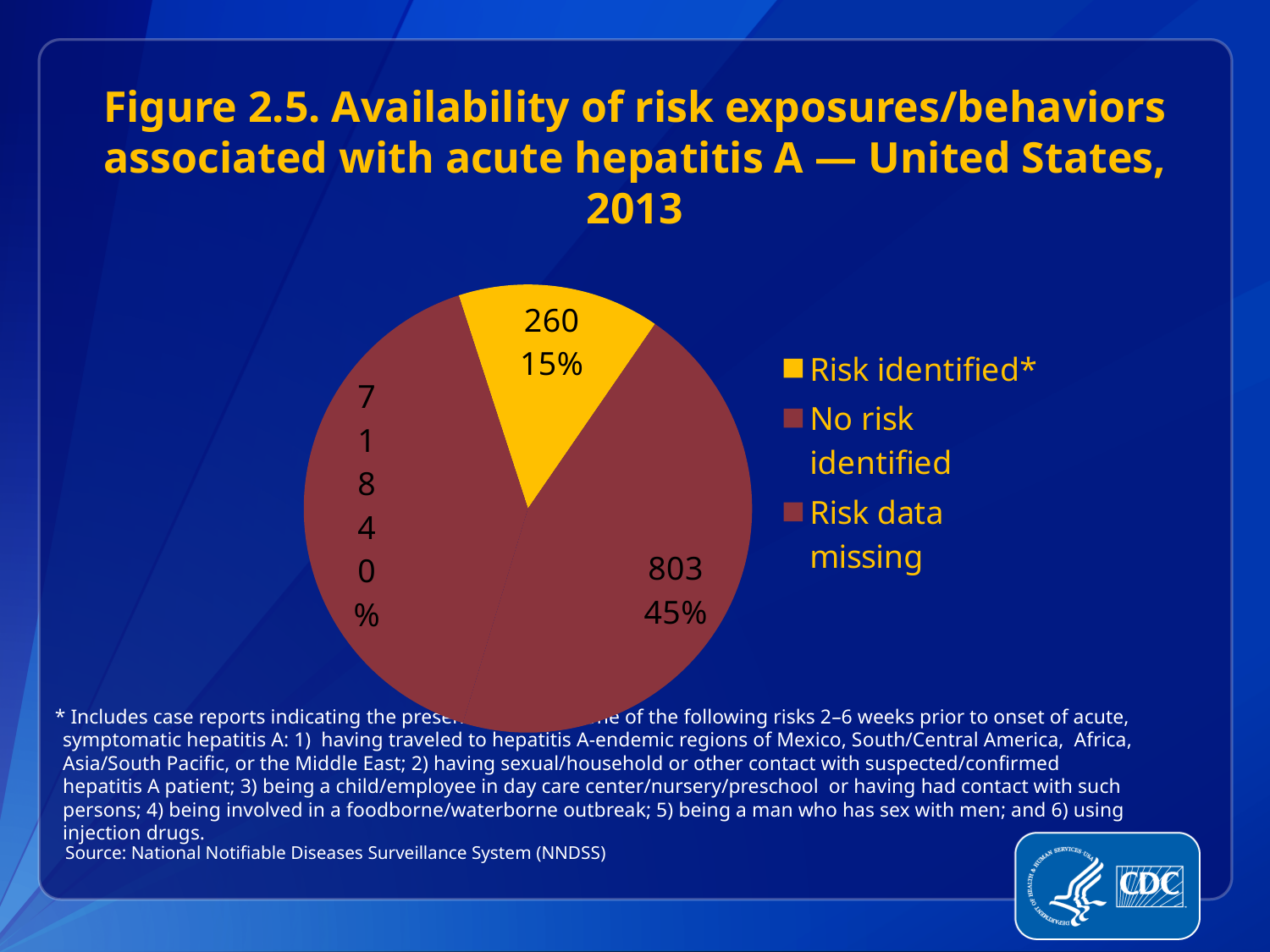
What is the value of the largest slice of the pie? 803 What kind of chart is shown on the slide? pie chart What percentage share of the pie is the Risk identified* slice? 15% What colour is the Risk identified* slice? yellow What percentage is shown for the slice labeled 718? 40% What percentage is shown for the largest slice of the pie? 45% How many entries does the legend list? 3 What is the number of cases for the Risk identified* slice? 260 How many slices does the pie chart have? 3 What is the difference between the slice labeled 803 and the slice labeled 718? 85 What is the total of all three slice values in the pie chart? 1781 Which slice is the smallest in the pie chart? Risk identified*